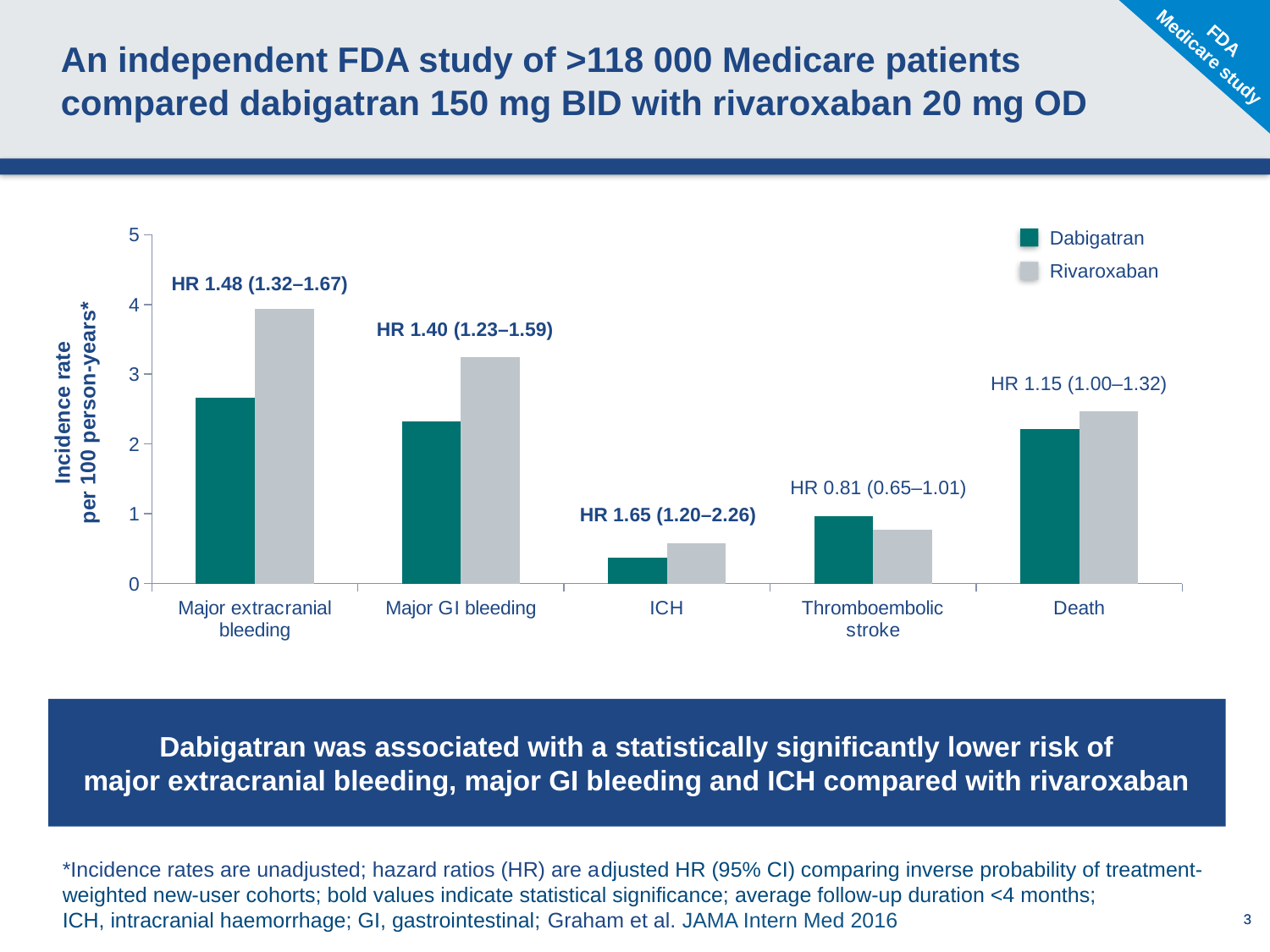
Is the Rivaroxaban incidence rate for Death greater or less than 3? less What kind of chart is shown on the slide? bar chart Is the Dabigatran incidence rate for ICH greater or less than 1? less For Thromboembolic stroke, which series has the higher incidence rate, Dabigatran or Rivaroxaban? Dabigatran Which category has the highest Rivaroxaban incidence rate? Major extracranial bleeding How many categories are shown on the x axis of the chart? 5 What hazard ratio is printed above the ICH bars? HR 1.65 (1.20–2.26) For Major extracranial bleeding, which series has the higher incidence rate, Dabigatran or Rivaroxaban? Rivaroxaban What is the y-axis label of the chart? Incidence rate per 100 person-years* Which category has the lowest Dabigatran incidence rate? ICH How many series does the chart legend list? 2 Is the Rivaroxaban incidence rate for Major extracranial bleeding greater or less than 3? greater